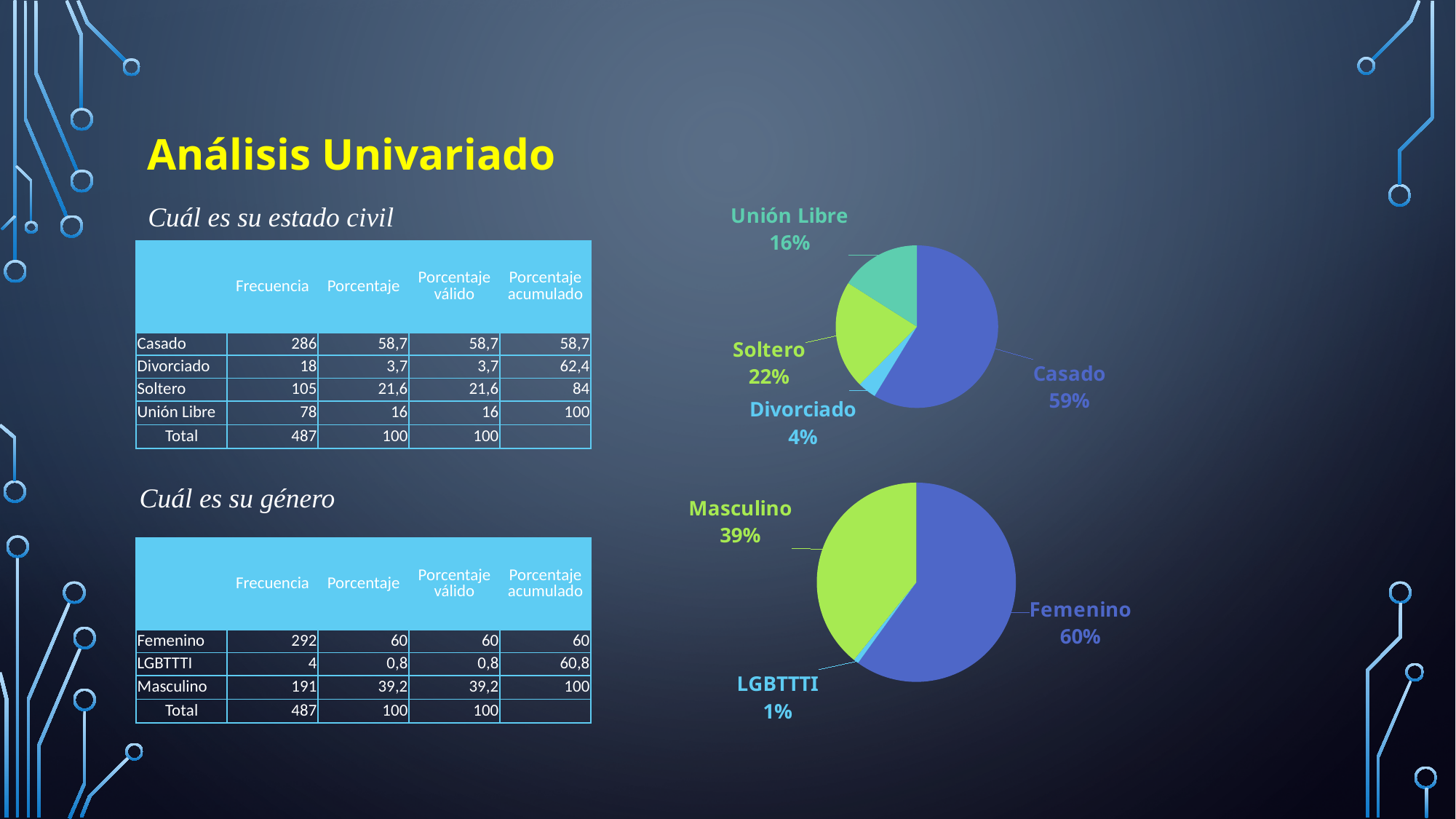
In the top pie chart (estado civil), what percentage is shown for Soltero? 22% In the bottom pie chart (género), which category has the largest share? Femenino In the bottom pie chart (género), what is the difference in percentage points between Femenino and Masculino? 21 In the top pie chart (estado civil), which category has the largest slice? Casado In the bottom pie chart (género), what percentage is shown for LGBTTTI? 1% What type of chart is used for the género data on the slide? Pie chart In the bottom pie chart (género), what percentage is shown for Masculino? 39% In the top pie chart (estado civil), how many slices are there? 4 In the top pie chart (estado civil), what percentage is shown for Unión Libre? 16% In the top pie chart (estado civil), which category has the smallest slice? Divorciado In the top pie chart (estado civil), what percentage is shown for Casado? 59% In the top pie chart (estado civil), what is the difference in percentage points between Soltero and Unión Libre? 6